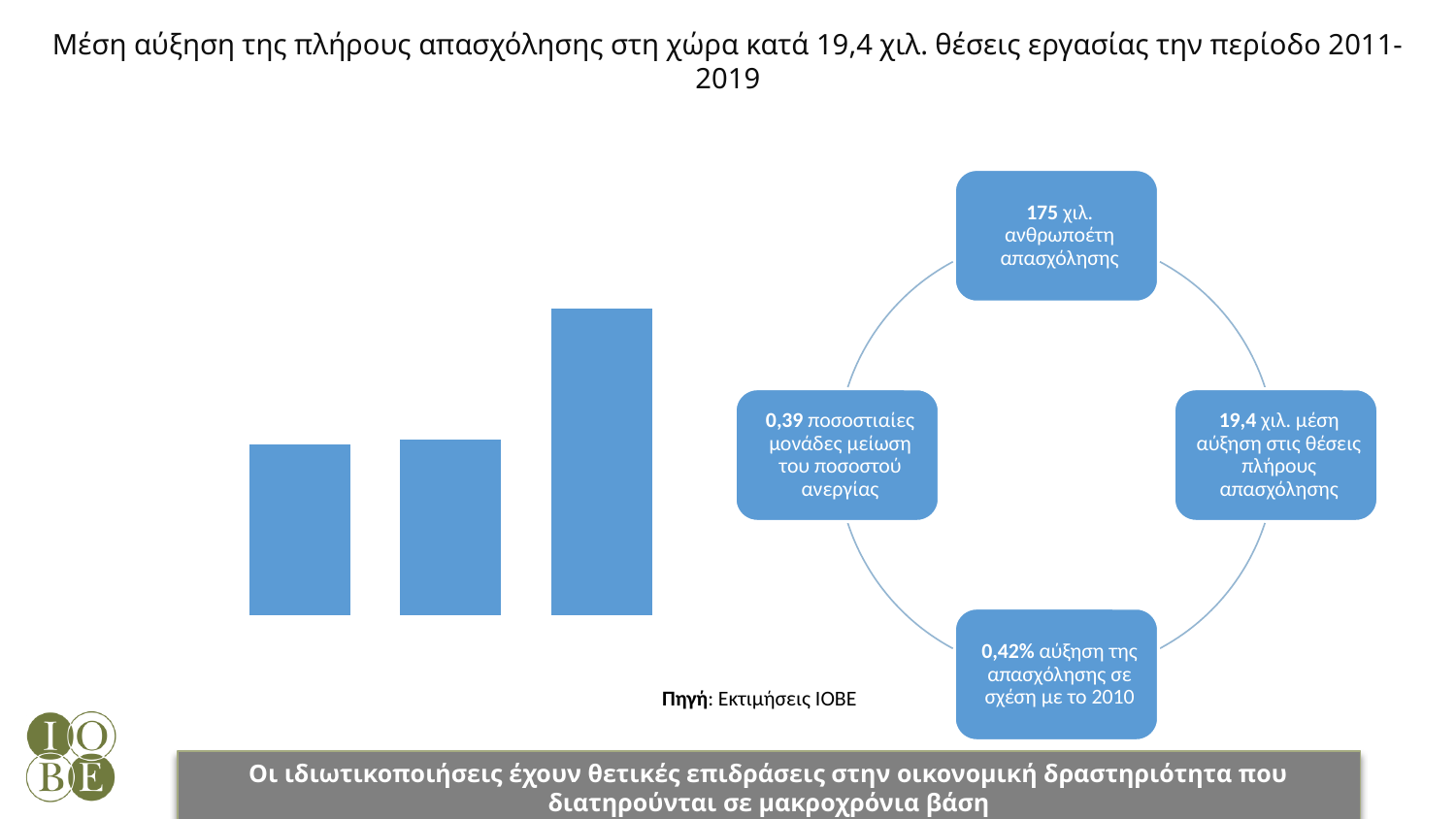
What colour are the bars in the bar chart on the left of the slide? blue How many bars does the bar chart on the left of the slide have? 3 What kind of chart is shown on the left of the slide? bar chart In the bar chart on the left of the slide, is the middle bar taller or shorter than the rightmost bar? shorter In the bar chart on the left of the slide, is the rightmost bar taller or shorter than the leftmost bar? taller In the bar chart on the left of the slide, which bar is the tallest: the leftmost, the middle or the rightmost? the rightmost Does the bar chart on the left of the slide show data labels on its bars? No